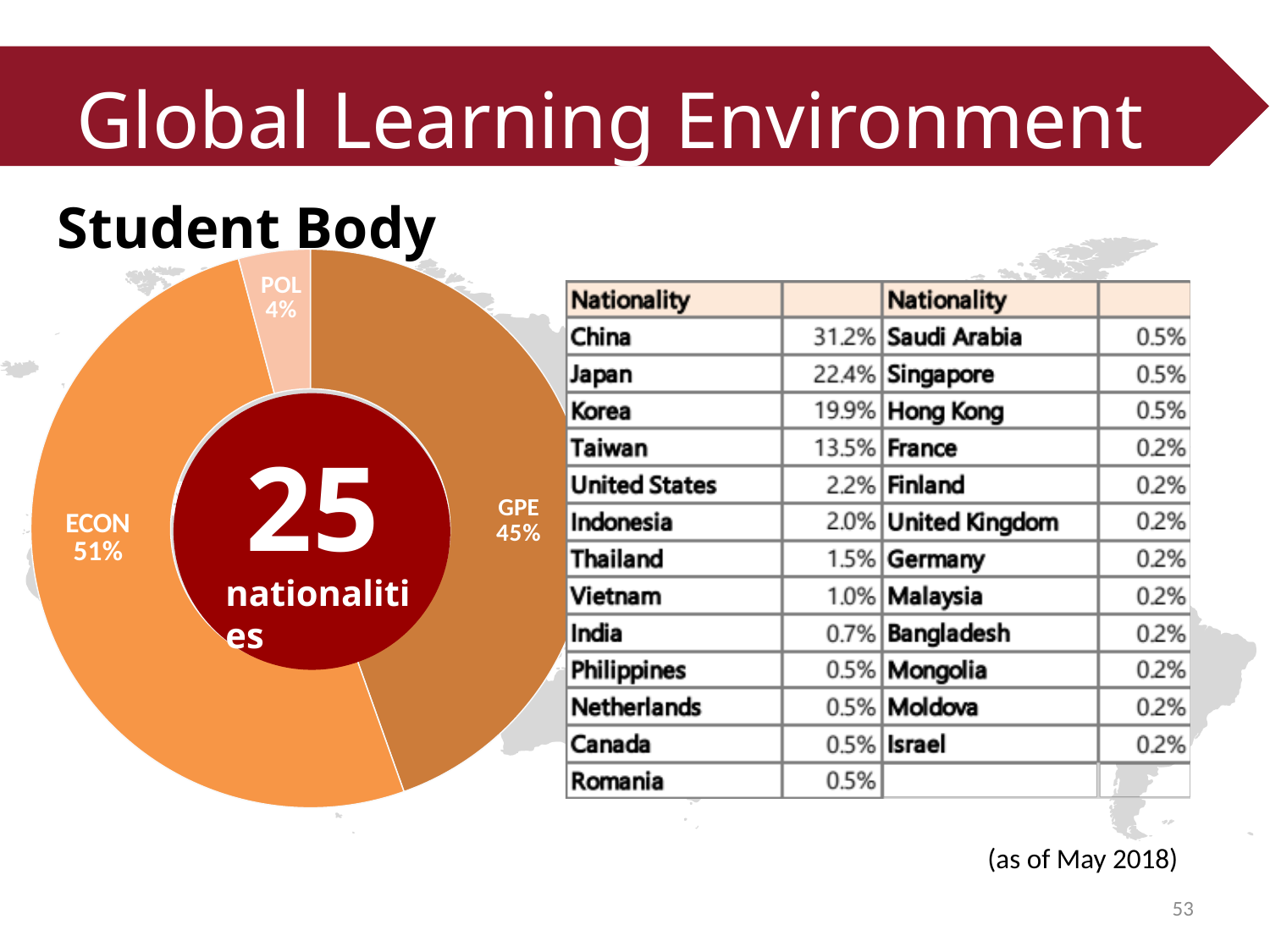
What type of chart is used to show the Student Body breakdown? Doughnut (pie) chart What is the combined share of ECON and GPE in the doughnut chart? 96% What percentage does the POL segment of the doughnut chart show? 4% By how many percentage points does the ECON share exceed the GPE share in the doughnut chart? 6% What share of the student body is in ECON according to the doughnut chart? 51% What number is displayed in the center of the doughnut chart? 25 nationalities Which program has the largest share in the Student Body doughnut chart? ECON What percentage does the GPE segment of the doughnut chart show? 45% By how many percentage points does the GPE share exceed the POL share in the doughnut chart? 41% How many segments does the Student Body doughnut chart have? 3 Which segment is larger in the doughnut chart, GPE or POL? GPE Which program has the smallest share in the Student Body doughnut chart? POL